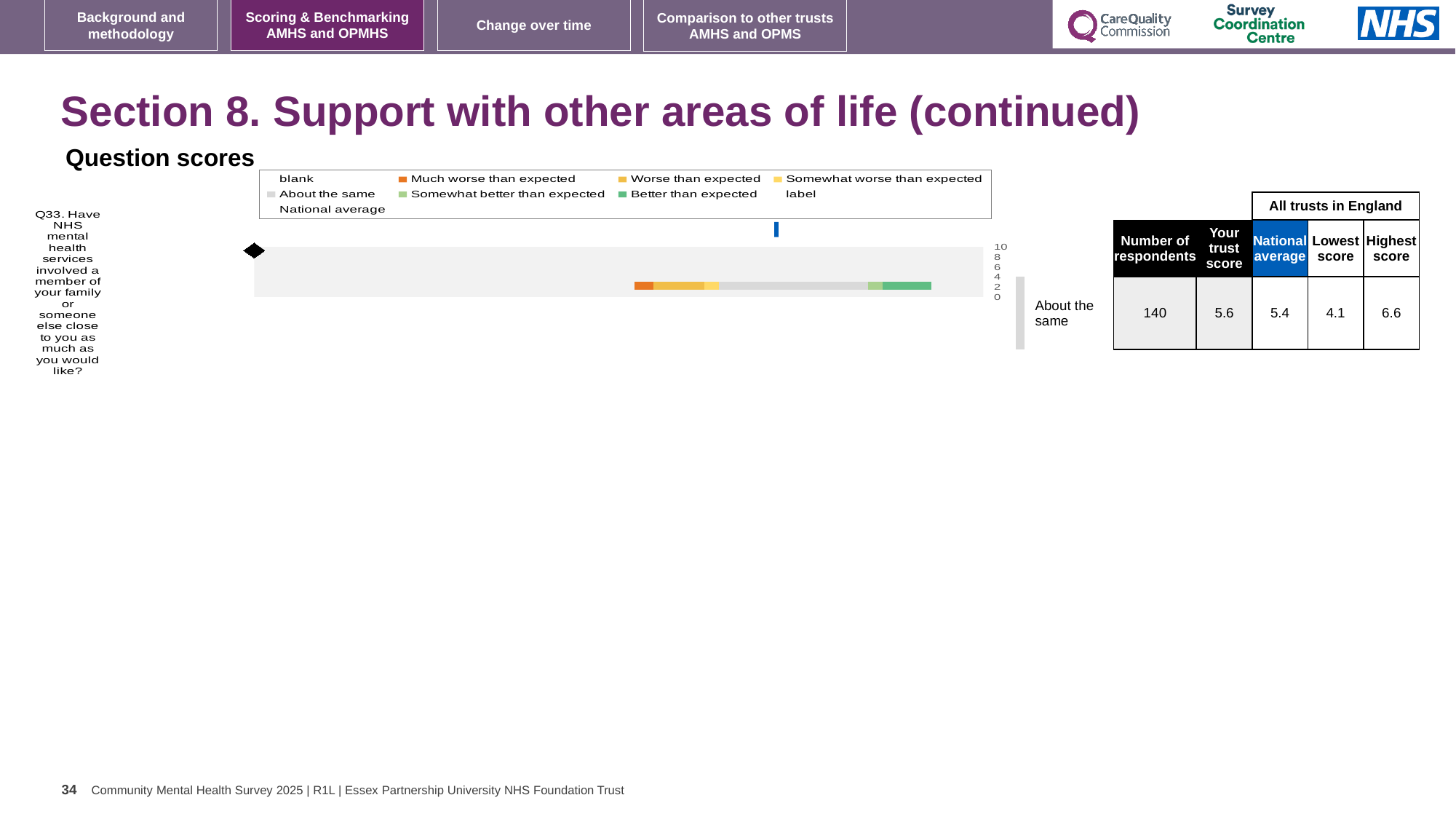
What kind of chart is shown under 'Question scores'? bar chart Which question number is plotted in the Question scores chart? Q33 In the table beside the chart, what is the trust's score for Q33? 5.6 How many survey questions are plotted in the Question scores chart? 1 What colour represents 'Much worse than expected' in the chart legend? orange For Q33, what is the difference between the highest score (6.6) and the lowest score (4.1) across all trusts in England? 2.5 How many entries does the legend of the Question scores chart list? 9 For Q33, which is larger: the trust score or the national average? the trust score In the table beside the chart, what is the number of respondents for Q33? 140 What benchmark category is shown for Q33 next to the chart? About the same In the table beside the chart, what is the national average for Q33? 5.4 What is the highest value shown on the chart's axis? 10